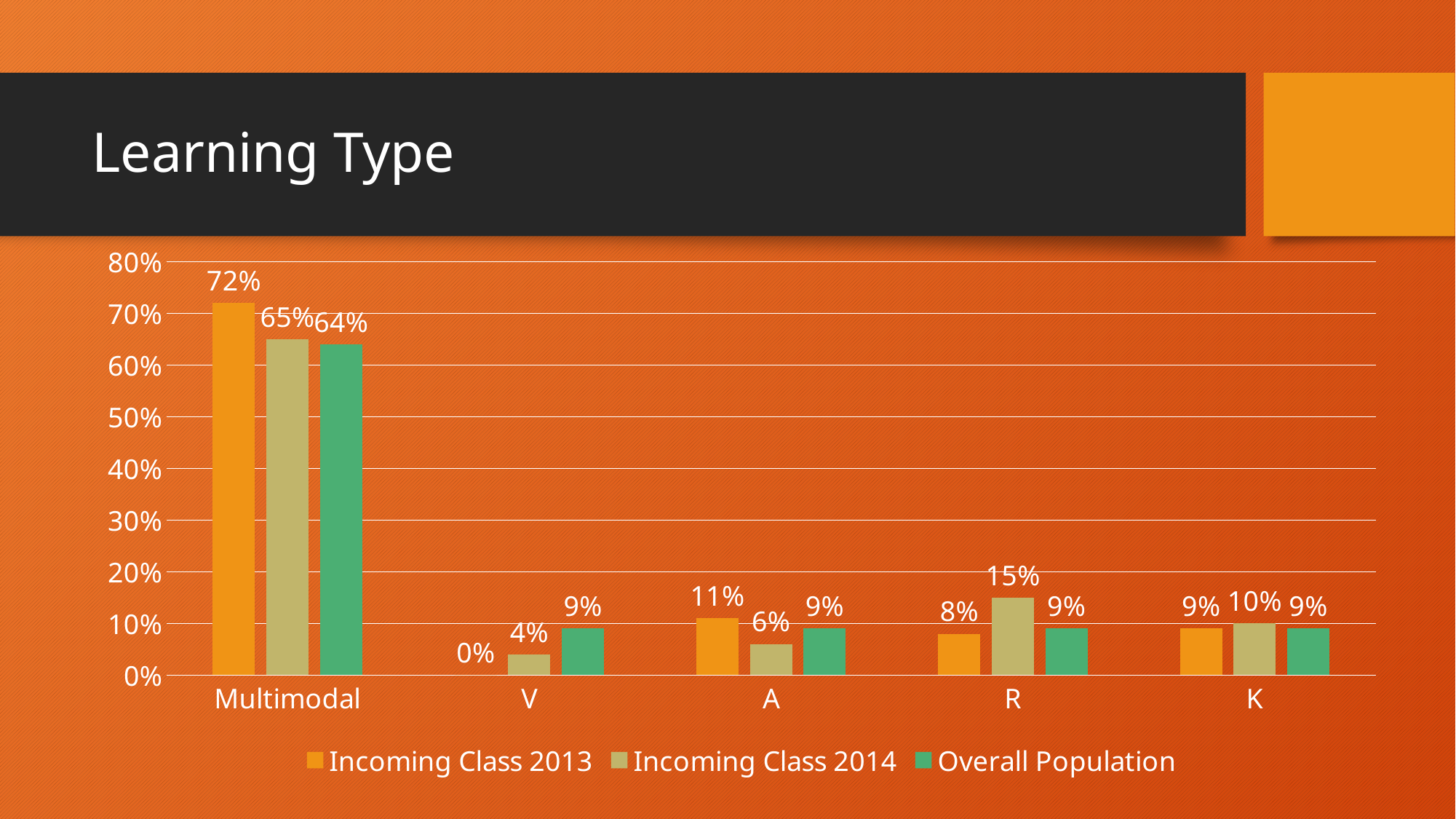
What is the value for Incoming Class 2013 in the Multimodal category? 72% What is the title of the slide containing the chart? Learning Type What is the value for Incoming Class 2013 in the V category? 0% What kind of chart is shown on the slide? Bar chart Which category has the lowest value for Incoming Class 2013? V What is the value for Incoming Class 2014 in the R category? 15% Which is larger in the A category: Incoming Class 2013 or Incoming Class 2014? Incoming Class 2013 What is the difference between Incoming Class 2013 and Overall Population in the Multimodal category? 8% What is the value for Overall Population in the V category? 9% How many series does the legend list? 3 Which category has the highest value for Incoming Class 2014? Multimodal How many categories are shown on the x axis? 5